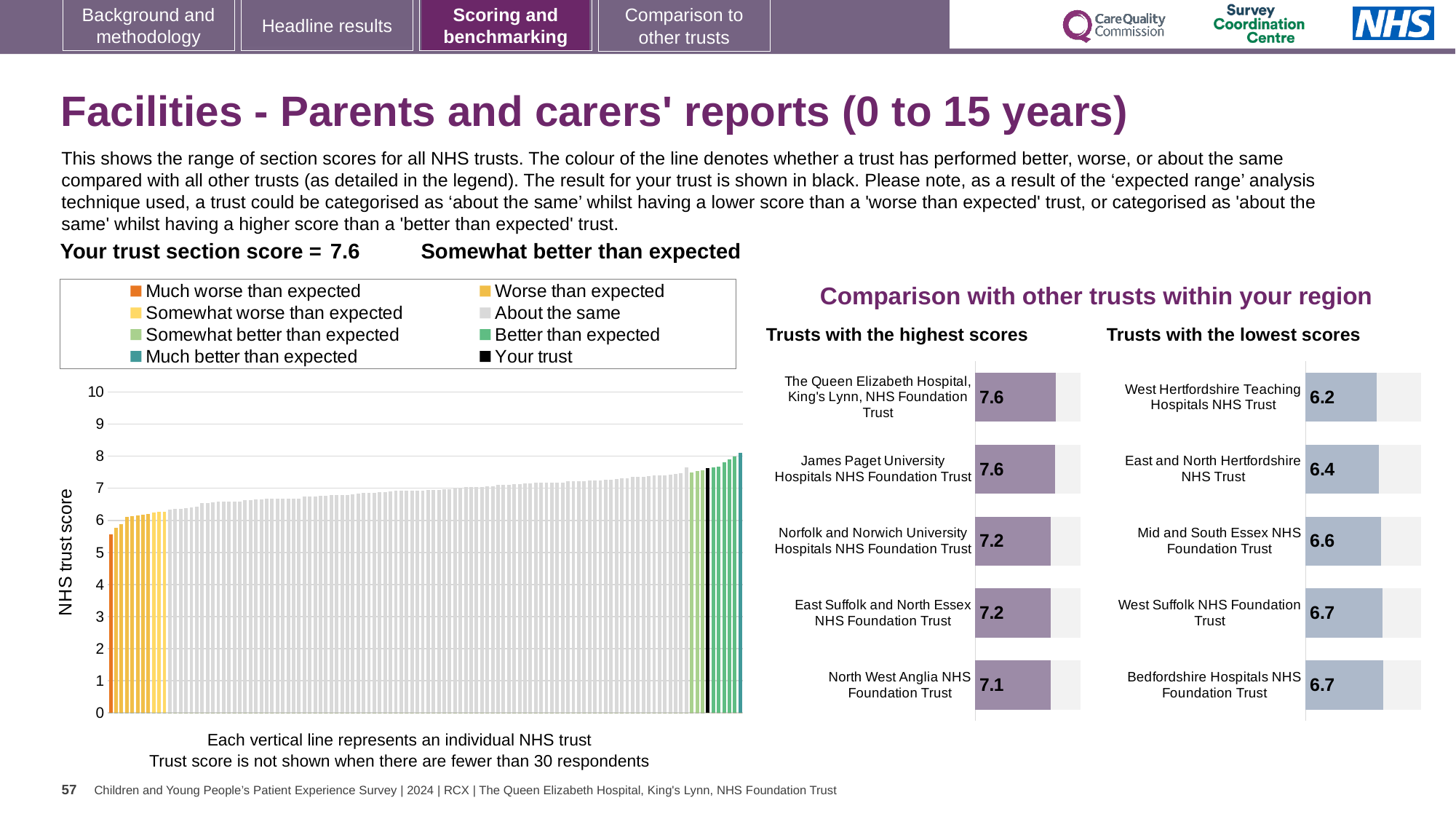
In the main chart on the left, do the bar values rise or fall from left to right? rise In the 'Trusts with the highest scores' chart, which trust has the lowest score? North West Anglia NHS Foundation Trust What is the y-axis label of the main chart on the left? NHS trust score How many trusts are listed in the 'Trusts with the lowest scores' chart? 5 In the 'Trusts with the lowest scores' chart, what is the score for East and North Hertfordshire NHS Trust? 6.4 In the 'Trusts with the highest scores' chart, which has the higher score: Norfolk and Norwich University Hospitals NHS Foundation Trust or North West Anglia NHS Foundation Trust? Norfolk and Norwich University Hospitals NHS Foundation Trust In the 'Trusts with the lowest scores' chart, which trust has the lowest score? West Hertfordshire Teaching Hospitals NHS Trust How many entries does the legend of the main chart on the left list? 8 In the 'Trusts with the highest scores' chart, what is the difference between the score for The Queen Elizabeth Hospital, King's Lynn, NHS Foundation Trust and the score for North West Anglia NHS Foundation Trust? 0.5 In the 'Trusts with the lowest scores' chart, what is the difference between the score for Mid and South Essex NHS Foundation Trust and the score for West Hertfordshire Teaching Hospitals NHS Trust? 0.4 In the main chart on the left, is the value of the leftmost (lowest) bar greater or less than 6? less In the 'Trusts with the highest scores' chart, what is the score for North West Anglia NHS Foundation Trust? 7.1